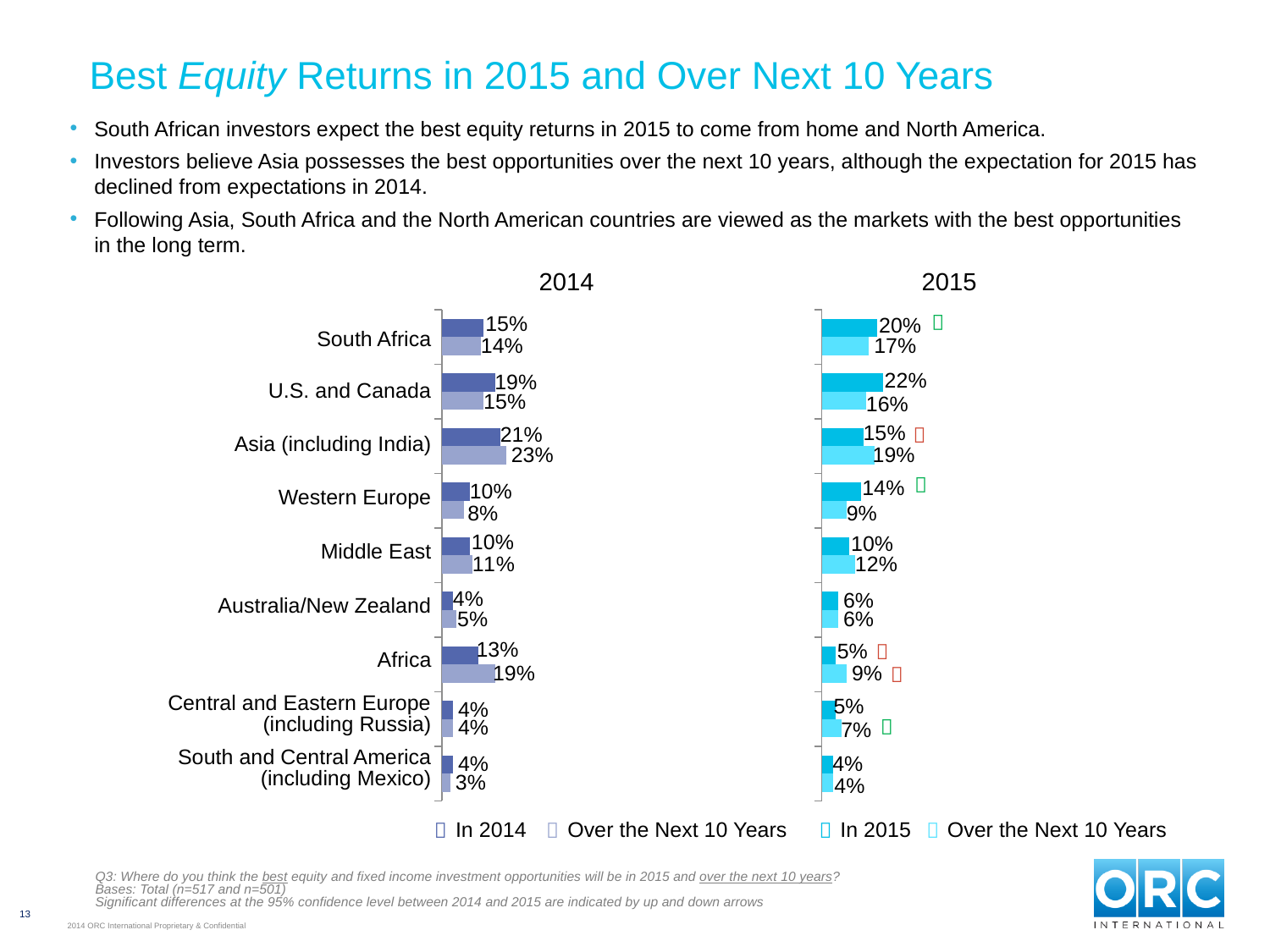
In the 2015 chart, what is the value for Asia (including India) in the 'Over the Next 10 Years' series? 19% In the 2014 chart, what is the value for South Africa in the 'In 2014' series? 15% In the 2014 chart, which category has the highest value in the 'Over the Next 10 Years' series? Asia (including India) In the 2015 chart, which is larger for Middle East: the 'In 2015' value or the 'Over the Next 10 Years' value? Over the Next 10 Years In the 2015 chart, what is the difference between the 'In 2015' and 'Over the Next 10 Years' values for Western Europe? 5% In the 2014 chart, which category has the lowest value in the 'Over the Next 10 Years' series? South and Central America (including Mexico) How many series does the legend list for the 2015 chart? 2 In the 2015 chart, what is the value for U.S. and Canada in the 'In 2015' series? 22% In the 2015 chart, which category has the highest value in the 'In 2015' series? U.S. and Canada How many categories are shown in the 2014 chart? 9 In the 2014 chart, what is the difference between the 'Over the Next 10 Years' and 'In 2014' values for Africa? 6% What kind of chart is the 2015 chart? Bar chart